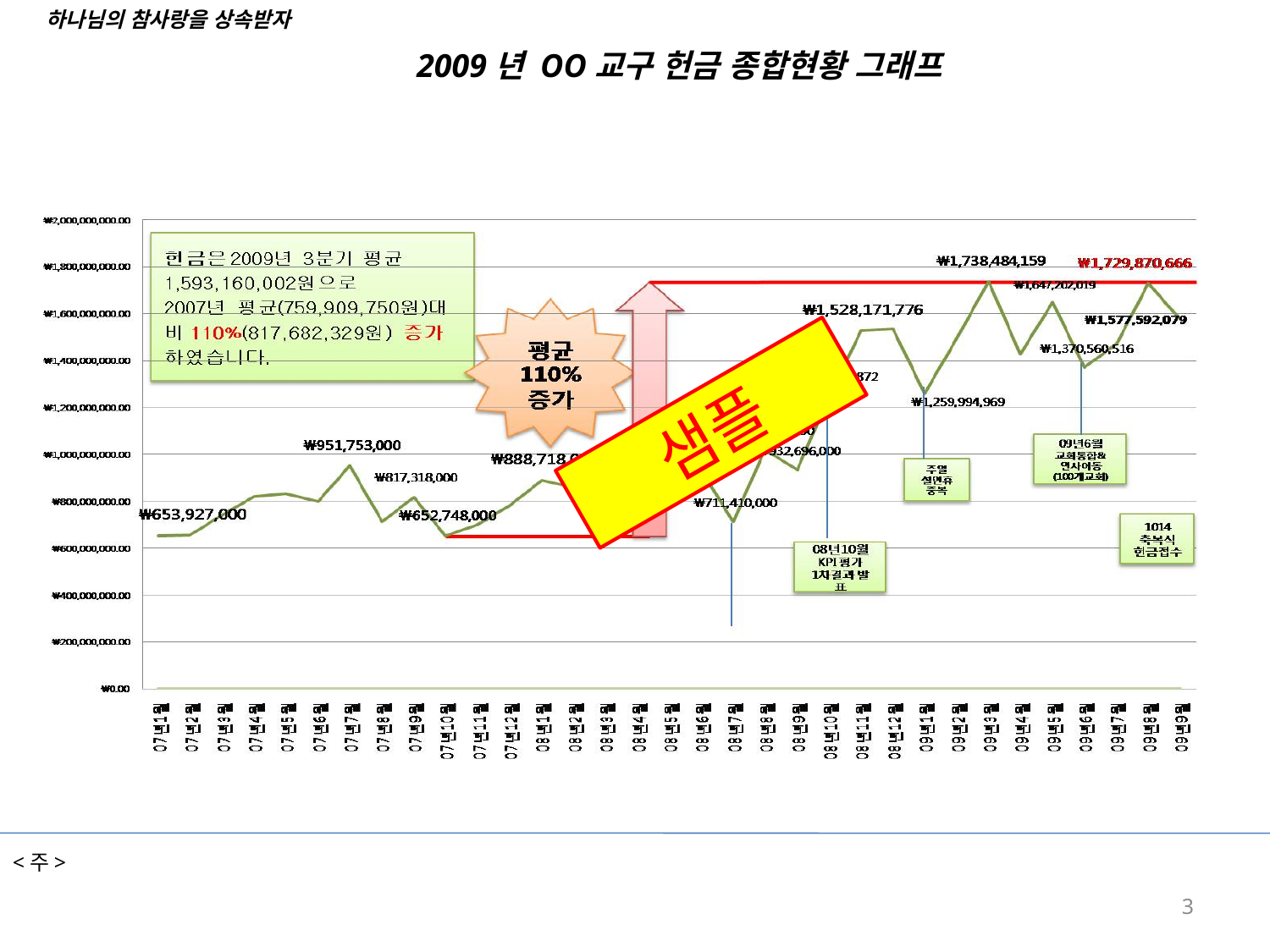
Overall, do the values rise or fall from 07년1월 to 09년9월? rise How many monthly data points are plotted along the x axis? 33 What kind of chart is shown on the slide? line chart Is the value for 08년7월 greater or less than ₩800,000,000.00? less What is the highest value printed as a data label on the chart? ₩1,738,484,159 What is the difference between the values for 07년7월 and 07년10월? ₩299,005,000 What is the value labelled for 07년10월? ₩652,748,000 What is the title of the chart on the slide? 2009 년 OO 교구 헌금 종합현황 그래프 What is the value labelled for 09년3월? ₩1,738,484,159 Which is larger, the value for 07년7월 or the value for 08년7월? 07년7월 What is the value labelled for 08년7월? ₩711,410,000 What is the value labelled for 07년7월? ₩951,753,000